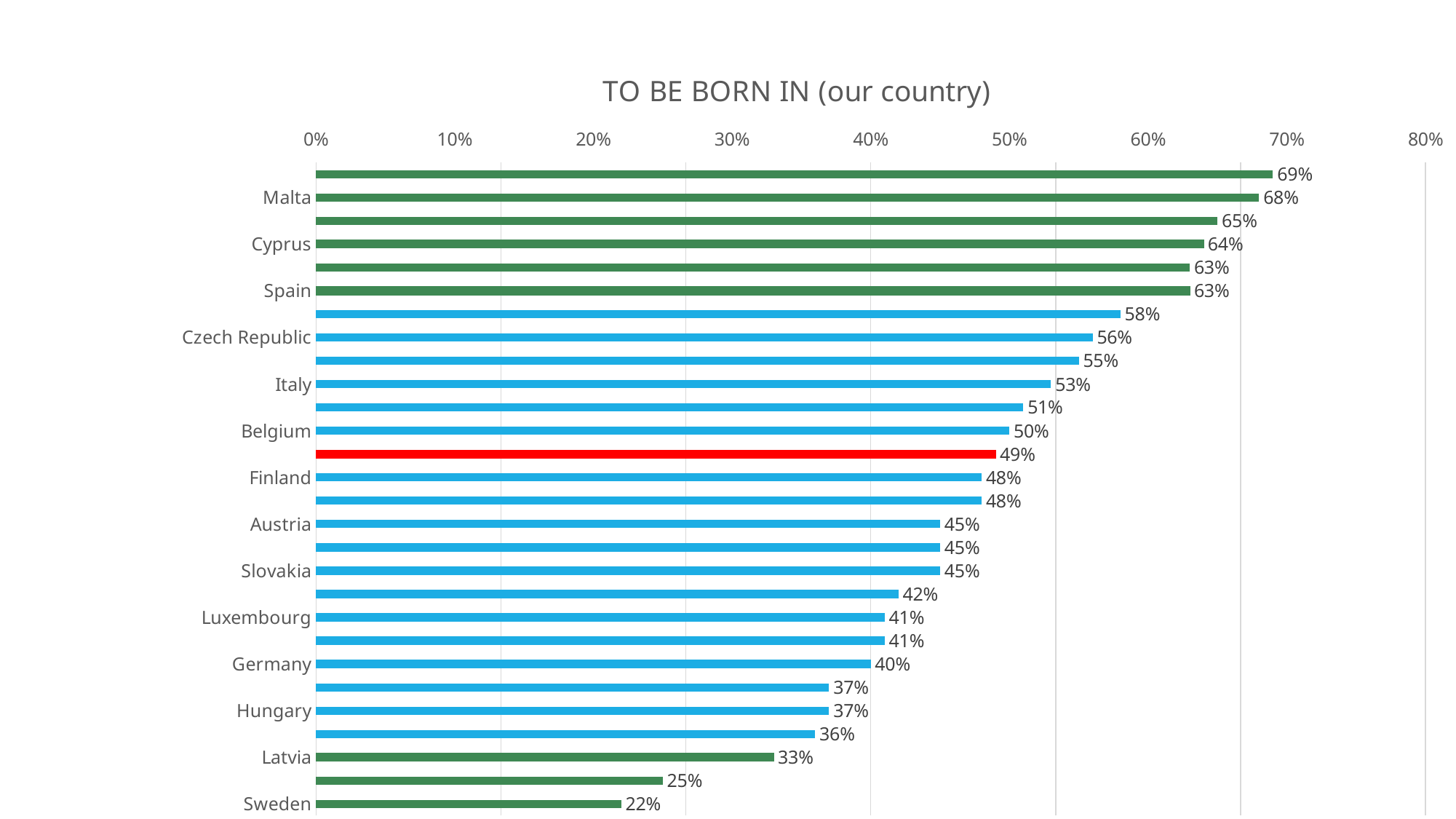
What kind of chart is shown on the slide? Bar chart What is the value for Czech Republic? 56% Which has a larger value, Italy or Belgium? Italy What is the value for Italy? 53% What is the value for Germany? 40% What is the difference between the values for Malta and Sweden? 46 percentage points How many bars are plotted in the chart? 28 Which labelled country has the lowest value? Sweden What is the value for Malta? 68% What is the value for Sweden? 22% What is the value of the red bar? 49% What is the value for Cyprus? 64%